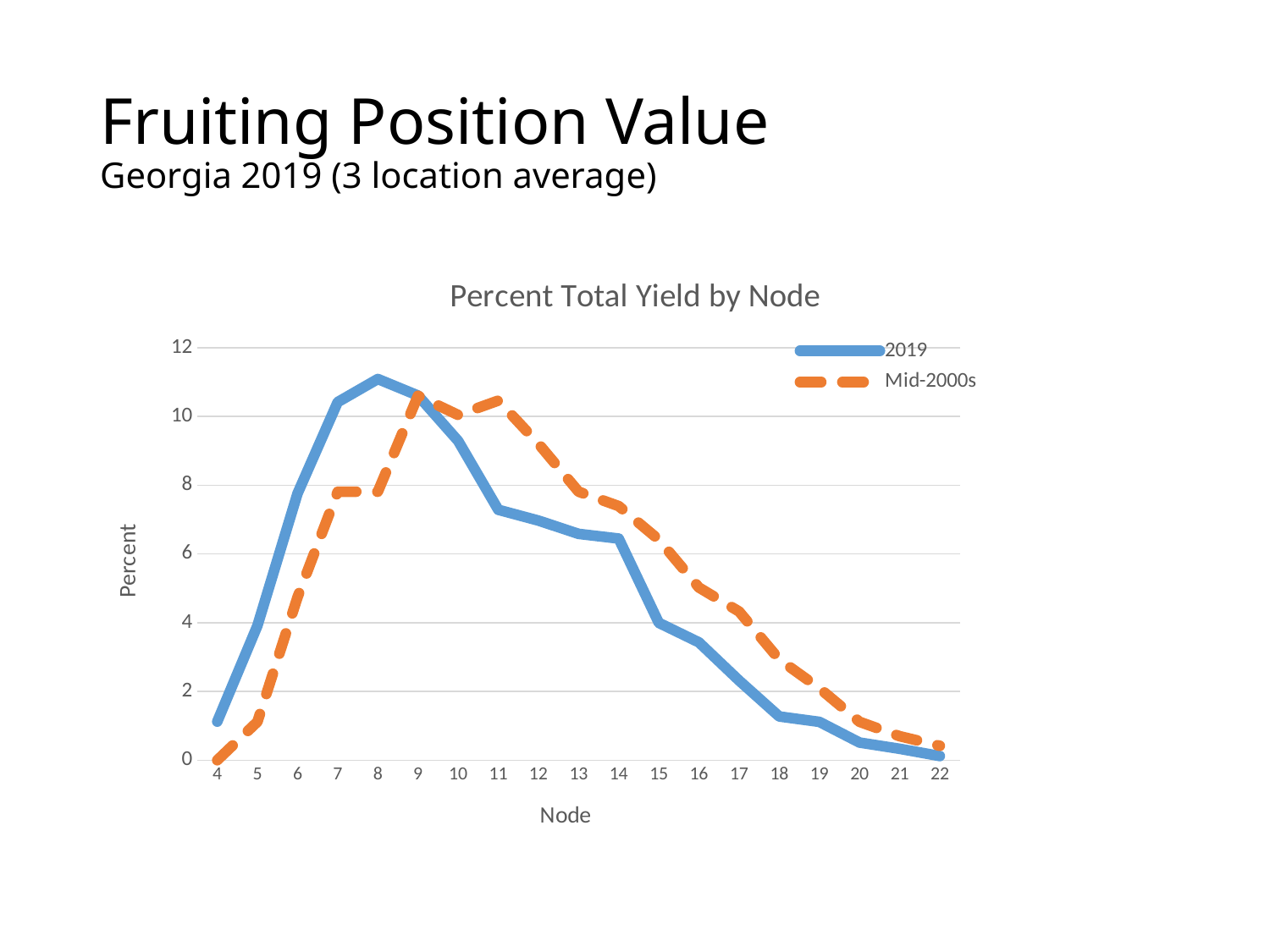
At node 6, which series has the larger value, 2019 or Mid-2000s? 2019 What kind of chart is shown on the slide? line chart Is the value for the Mid-2000s series at node 16 greater or less than 4? greater At which node does the Mid-2000s series have its lowest value? 4 How many series does the legend list? 2 What is the title of the chart? Percent Total Yield by Node How many nodes are plotted along the x axis? 19 At node 12, which series has the larger value, 2019 or Mid-2000s? Mid-2000s At which node does the 2019 series reach its highest value? 8 Is the value for the 2019 series at node 8 greater or less than 10? greater Is the value for the 2019 series at node 18 greater or less than 2? less At which node does the 2019 series have its lowest value? 22